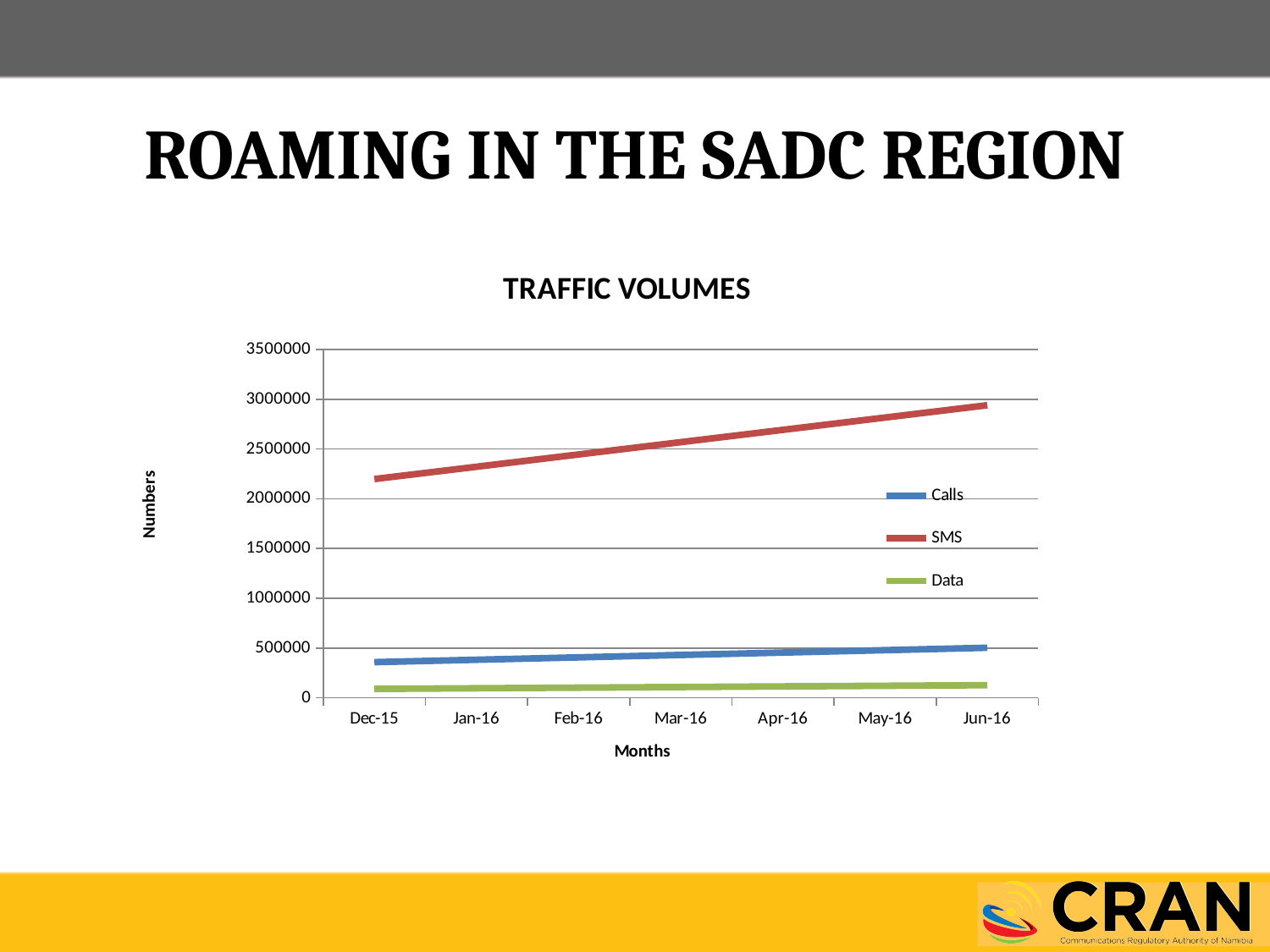
What is the title of the chart? TRAFFIC VOLUMES In Jun-16, which is larger, the SMS value or the Calls value? SMS What kind of chart is shown on the slide? line chart Is the SMS value for Jun-16 greater or less than 3000000? less How many series does the legend list? 3 How many months are shown along the x axis? 7 Which series has the lowest traffic volume throughout the period? Data Which series has the highest traffic volume throughout the period? SMS What is the label on the y axis of the chart? Numbers Is the SMS value for Dec-15 greater or less than 2000000? greater Does the SMS traffic volume rise or fall from Dec-15 to Jun-16? rise Is the Calls value for Dec-15 greater or less than 500000? less